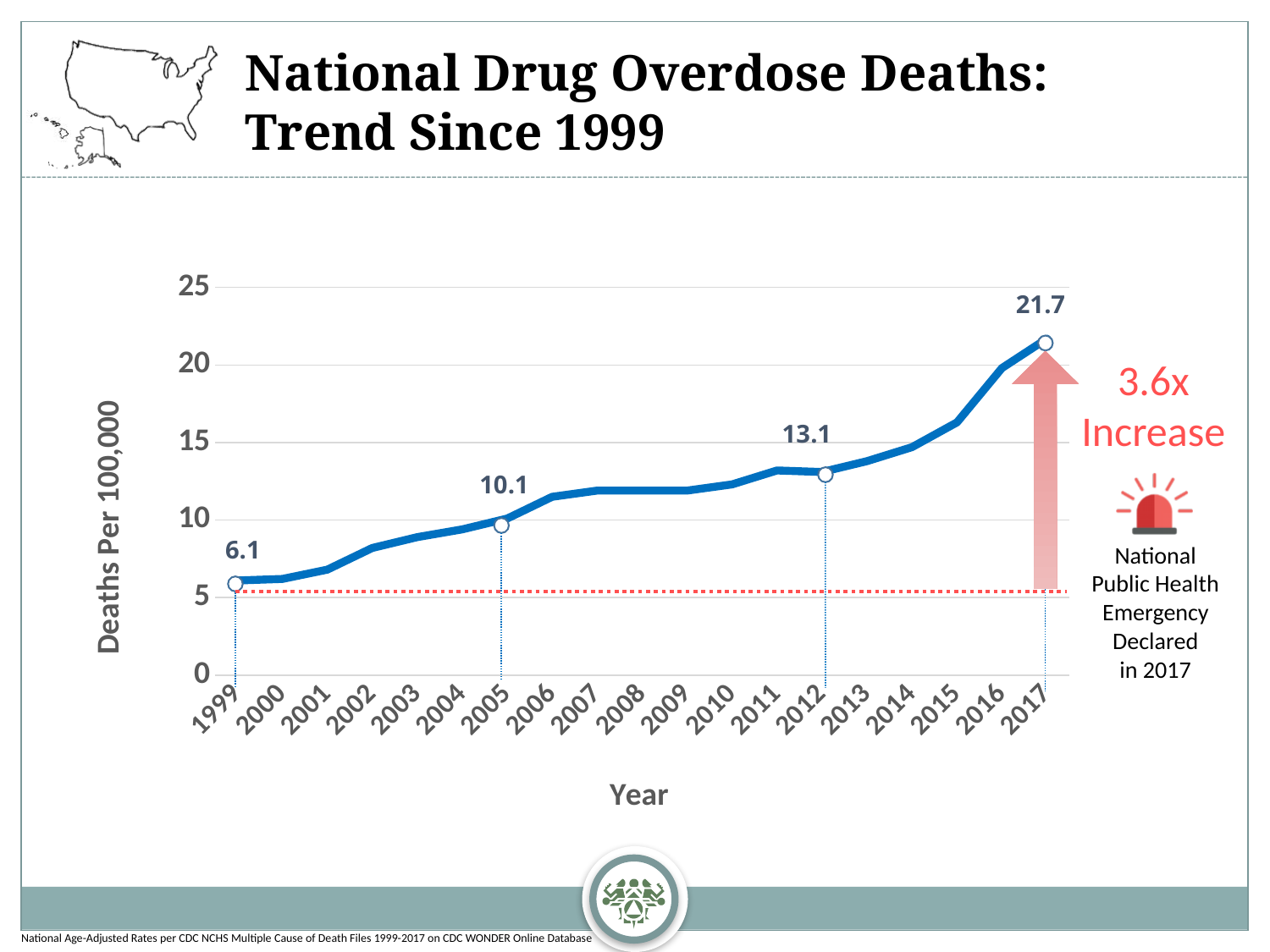
Do the death rates generally rise or fall from 1999 to 2017? rise What kind of chart is shown on the slide? line chart What is the death rate per 100,000 shown for 2012? 13.1 Is the value for 2002 greater or less than 10? less What is the death rate per 100,000 shown for 1999? 6.1 Which labeled year has the lowest death rate? 1999 What is the difference between the 2017 and 1999 death rates? 15.6 Which labeled year has the highest death rate? 2017 What is the death rate per 100,000 shown for 2017? 21.7 What is the difference between the 2012 and 2005 death rates? 3.0 Is the value for 2010 greater or less than 10? greater What is the death rate per 100,000 shown for 2005? 10.1